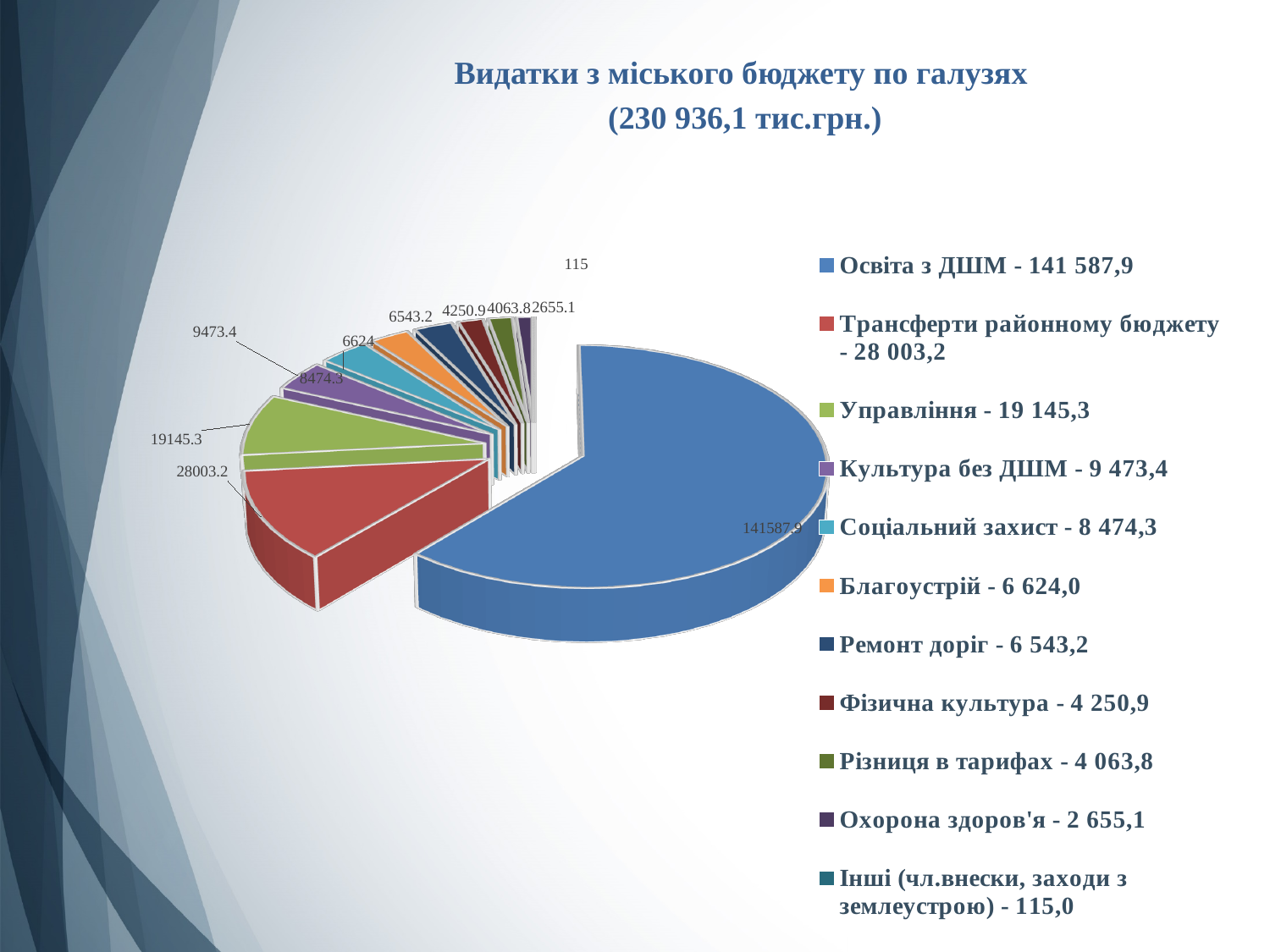
What is the value shown for Трансферти районному бюджету? 28003.2 What is the difference between the values for Благоустрій and Ремонт доріг? 80.8 Which is larger, the value for Культура без ДШМ or the value for Фізична культура? Культура без ДШМ What kind of chart is shown on the slide? pie chart What is the difference between the values for Трансферти районному бюджету and Управління? 8857.9 What total amount is given in the chart title? 230 936,1 тис.грн. How many categories does the pie chart have? 11 What is the value shown for Освіта з ДШМ? 141587.9 Which category has the largest slice of the pie? Освіта з ДШМ What is the value shown for Соціальний захист? 8474.3 What is the value shown for Інші (чл.внески, заходи з землеустрою)? 115 Which category has the smallest slice of the pie? Інші (чл.внески, заходи з землеустрою)